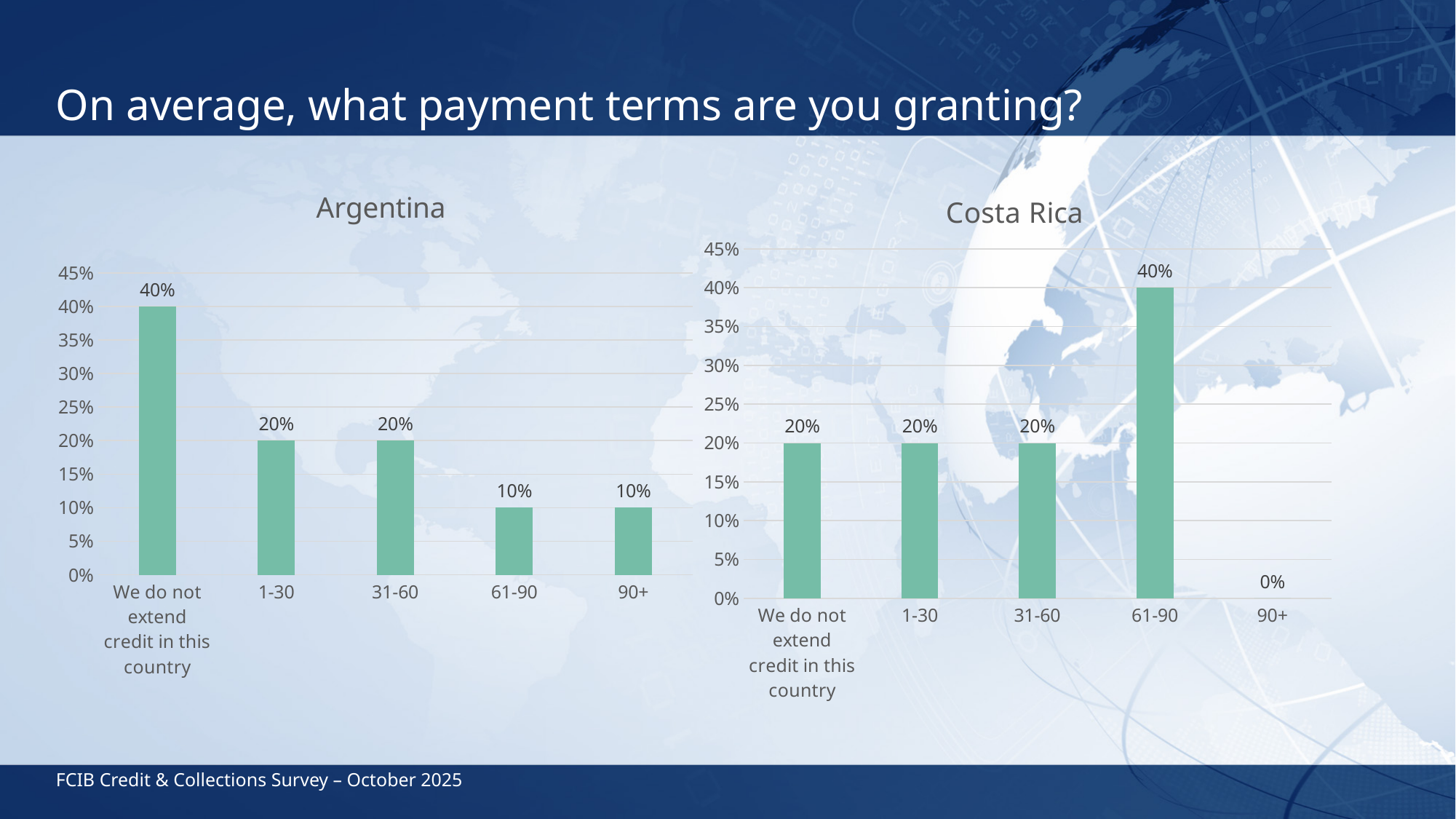
How many categories are shown in the Argentina chart? 5 What kind of chart is the Costa Rica chart? Bar chart In the Costa Rica chart, what is the difference between the value for 61-90 and the value for 31-60? 20% In the Argentina chart, what is the value for 'We do not extend credit in this country'? 40% In the Costa Rica chart, which category has the lowest value? 90+ In the Costa Rica chart, what is the value for 90+? 0% In the Argentina chart, which category has the highest value? We do not extend credit in this country In the Argentina chart, what is the difference between the value for 'We do not extend credit in this country' and the value for 1-30? 20% In the Costa Rica chart, what is the value for 61-90? 40% In the Argentina chart, what is the value for 61-90? 10% Which is larger: the value for 61-90 in the Argentina chart or the value for 61-90 in the Costa Rica chart? Costa Rica In the Costa Rica chart, which category has the highest value? 61-90